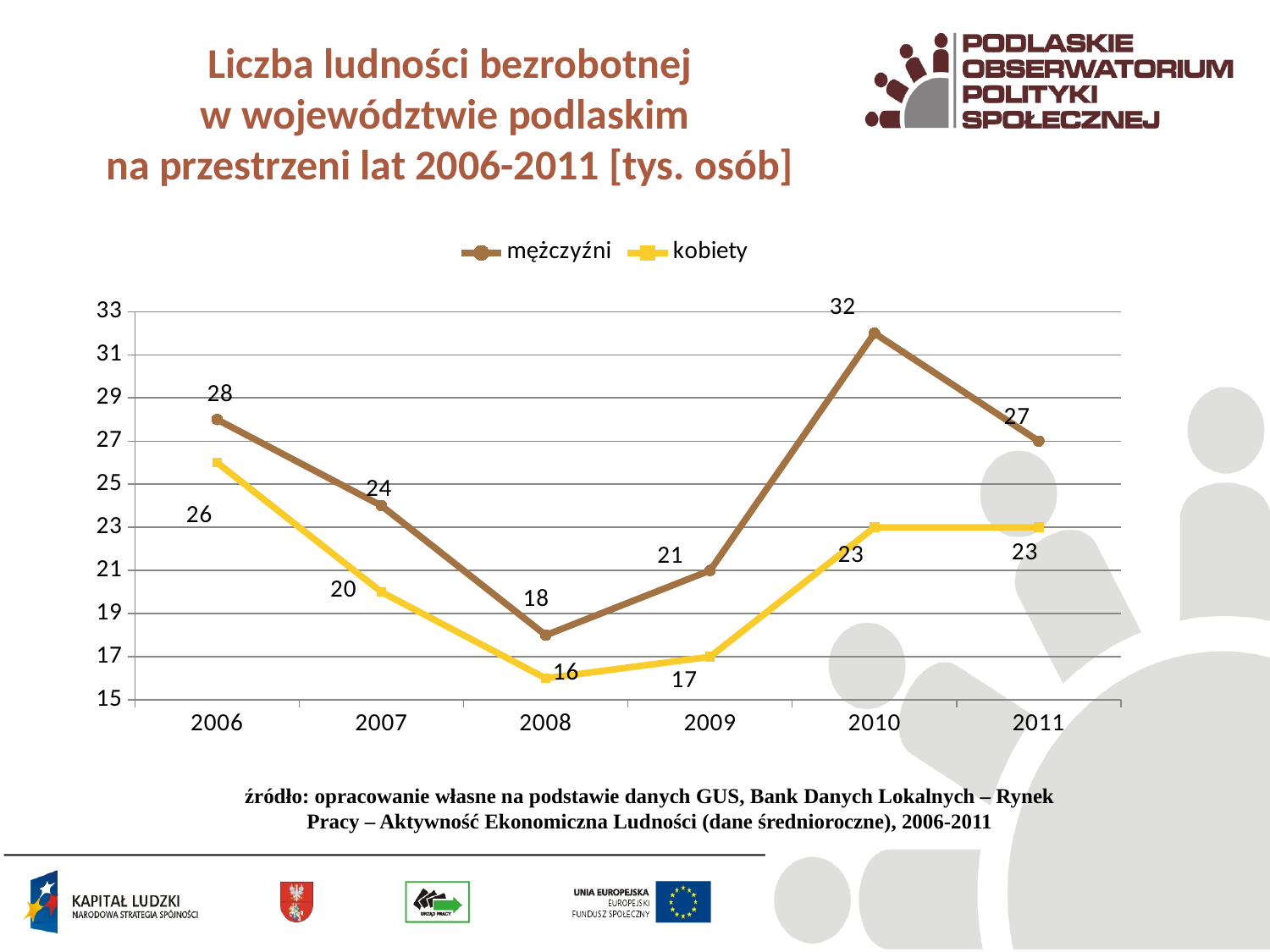
How many years are shown on the x axis? 6 In which year is the value for kobiety lowest? 2008 What is the value for kobiety in 2006? 26 How many series does the legend list? 2 What type of chart is shown on the slide? line chart Which series is drawn in yellow? kobiety Which is larger in 2007: mężczyźni or kobiety? mężczyźni What is the value for kobiety in 2008? 16 In which year is the value for mężczyźni highest? 2010 Does the value for mężczyźni rise or fall from 2006 to 2008? fall What is the difference between mężczyźni and kobiety in 2010? 9 What is the value for mężczyźni in 2010? 32